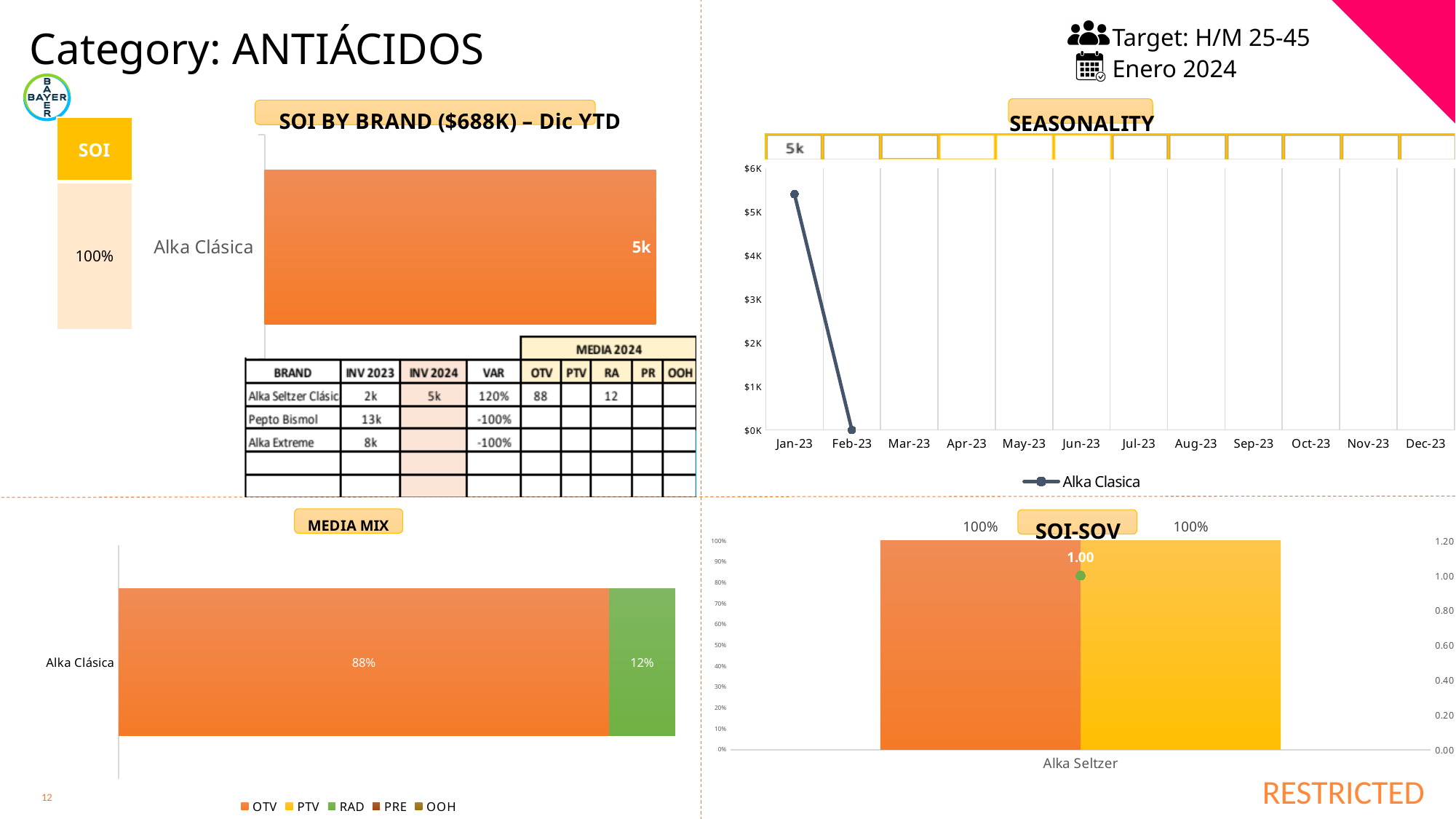
In the SEASONALITY chart, does the Alka Clasica line rise or fall from Jan-23 to Feb-23? fall What kind of chart is the SEASONALITY chart? line chart In the SOI BY BRAND chart, what value is shown for Alka Clásica? 5k In the SEASONALITY chart, is the value for Jan-23 greater or less than $4K? greater In the SOI-SOV chart, what value is shown by the data point label above the Alka Seltzer bars? 1.00 What kind of chart is the SOI BY BRAND chart? bar chart In the MEDIA MIX chart, what share does RAD have for Alka Clásica? 12% In the MEDIA MIX chart, what share does OTV have for Alka Clásica? 88% How many series does the legend of the MEDIA MIX chart list? 5 In the MEDIA MIX chart, what is the difference between the OTV and RAD shares for Alka Clásica? 76% How many months are shown on the x axis of the SEASONALITY chart? 12 In the SEASONALITY chart, what is the value for Feb-23? $0K